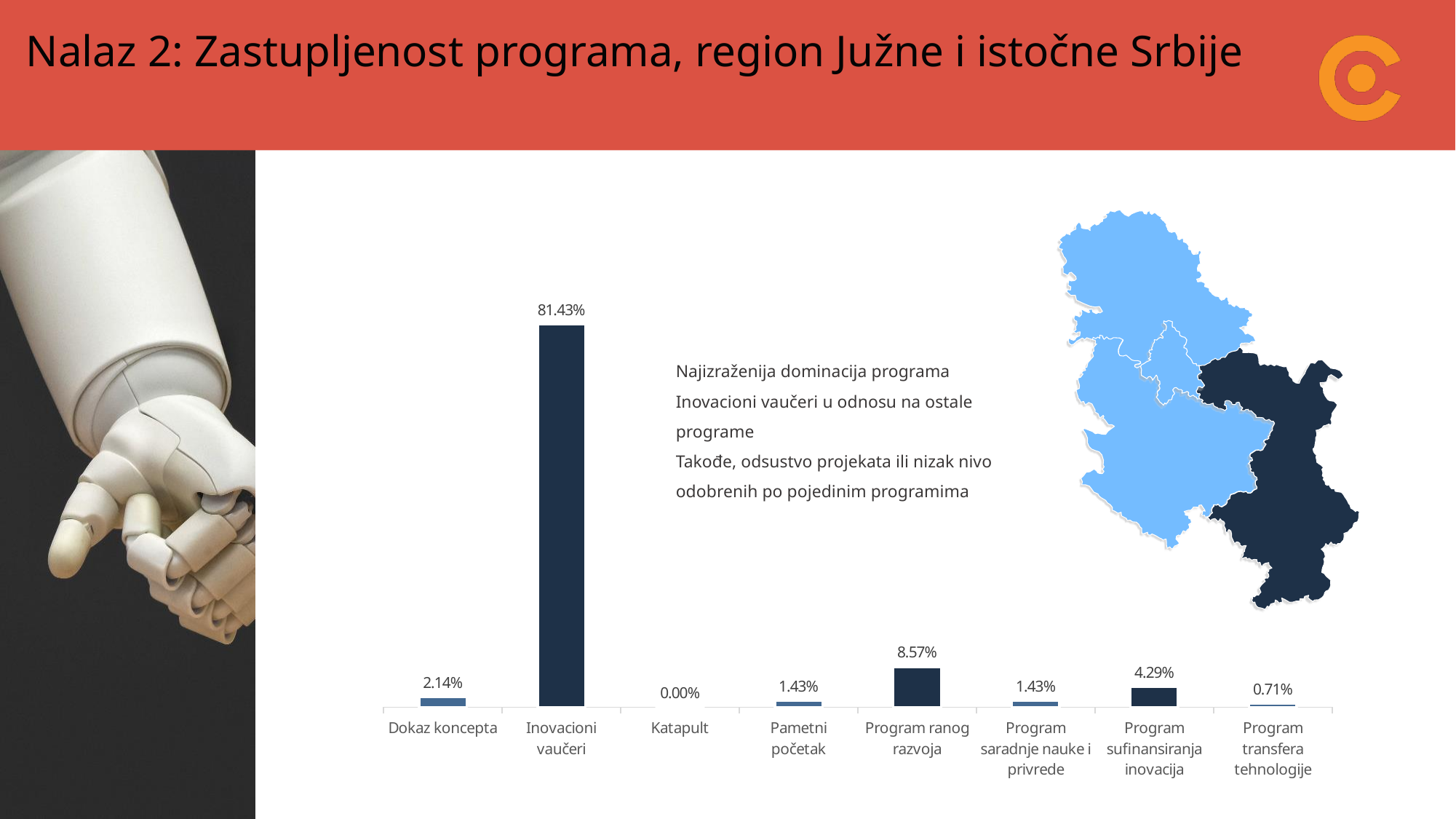
What is the value for Katapult? 0.00% What is the value for Program sufinansiranja inovacija? 4.29% What is the value for Inovacioni vaučeri? 81.43% What is the value for Program ranog razvoja? 8.57% Which category has the lowest value? Katapult What is the difference between the values for Inovacioni vaučeri and Program ranog razvoja? 72.86% Which is larger, the value for Dokaz koncepta or the value for Program sufinansiranja inovacija? Program sufinansiranja inovacija Which category has the highest value? Inovacioni vaučeri How many categories are shown on the x axis of the chart? 8 What is the value for Program transfera tehnologije? 0.71% What is the difference between the values for Program sufinansiranja inovacija and Dokaz koncepta? 2.15% What kind of chart is shown on the slide? Bar chart